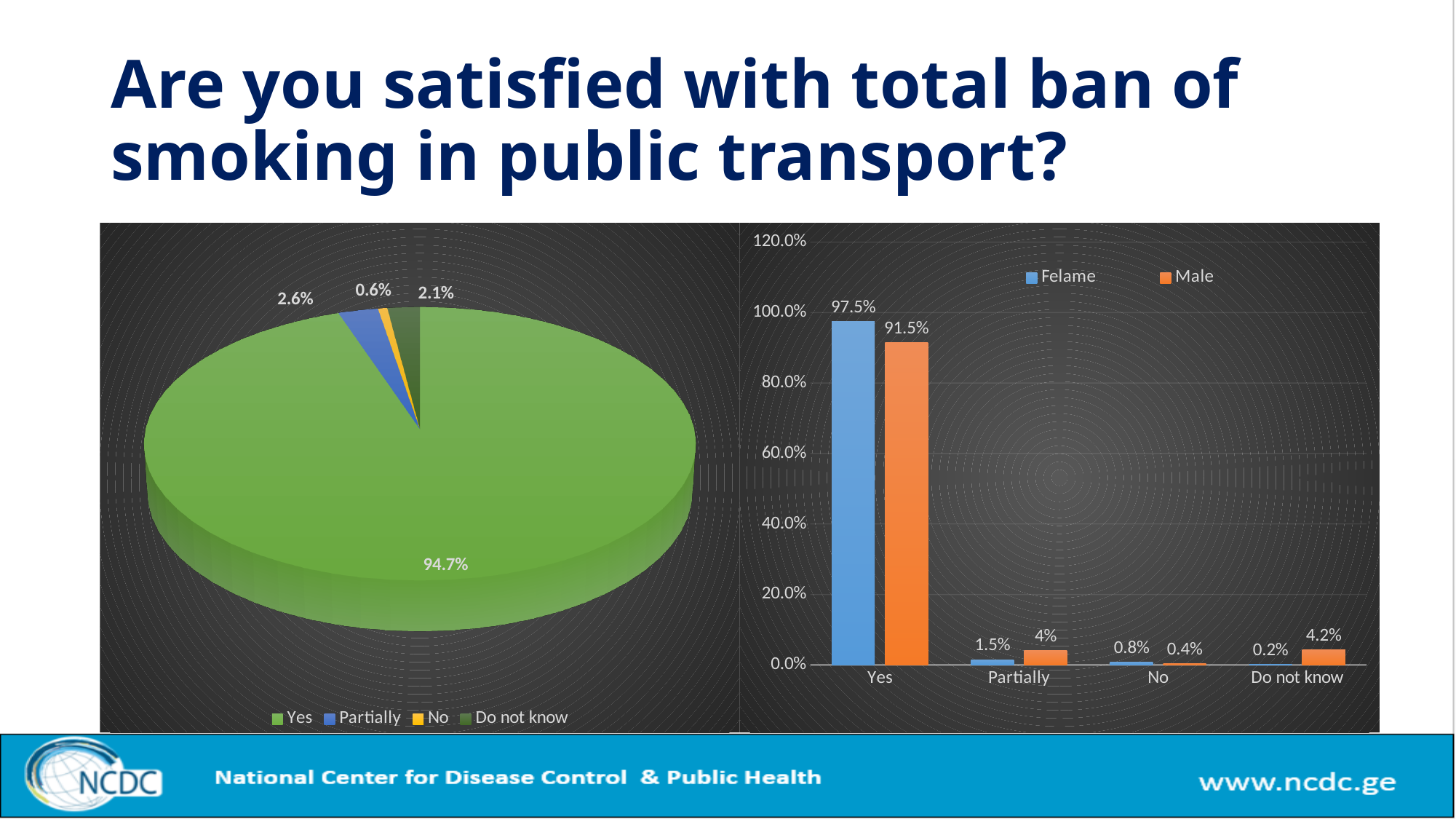
In the pie chart on the left, what share of respondents answered Partially? 2.6% What kind of chart is the chart on the right? Bar chart In the bar chart on the right, what is the Male value for Yes? 91.5% How many categories does the legend of the pie chart on the left list? 4 How many series does the legend of the bar chart on the right list? 2 In the bar chart on the right, what is the difference between the Felame and Male values for Yes? 6.0% In the pie chart on the left, what share of respondents answered Yes? 94.7% In the bar chart on the right, what is the Felame value for Partially? 1.5% What kind of chart is the chart on the left? Pie chart In the pie chart on the left, which category has the smallest slice? No In the bar chart on the right, what is the Male value for Do not know? 4.2% In the bar chart on the right, which is larger for No: the Felame value or the Male value? Felame